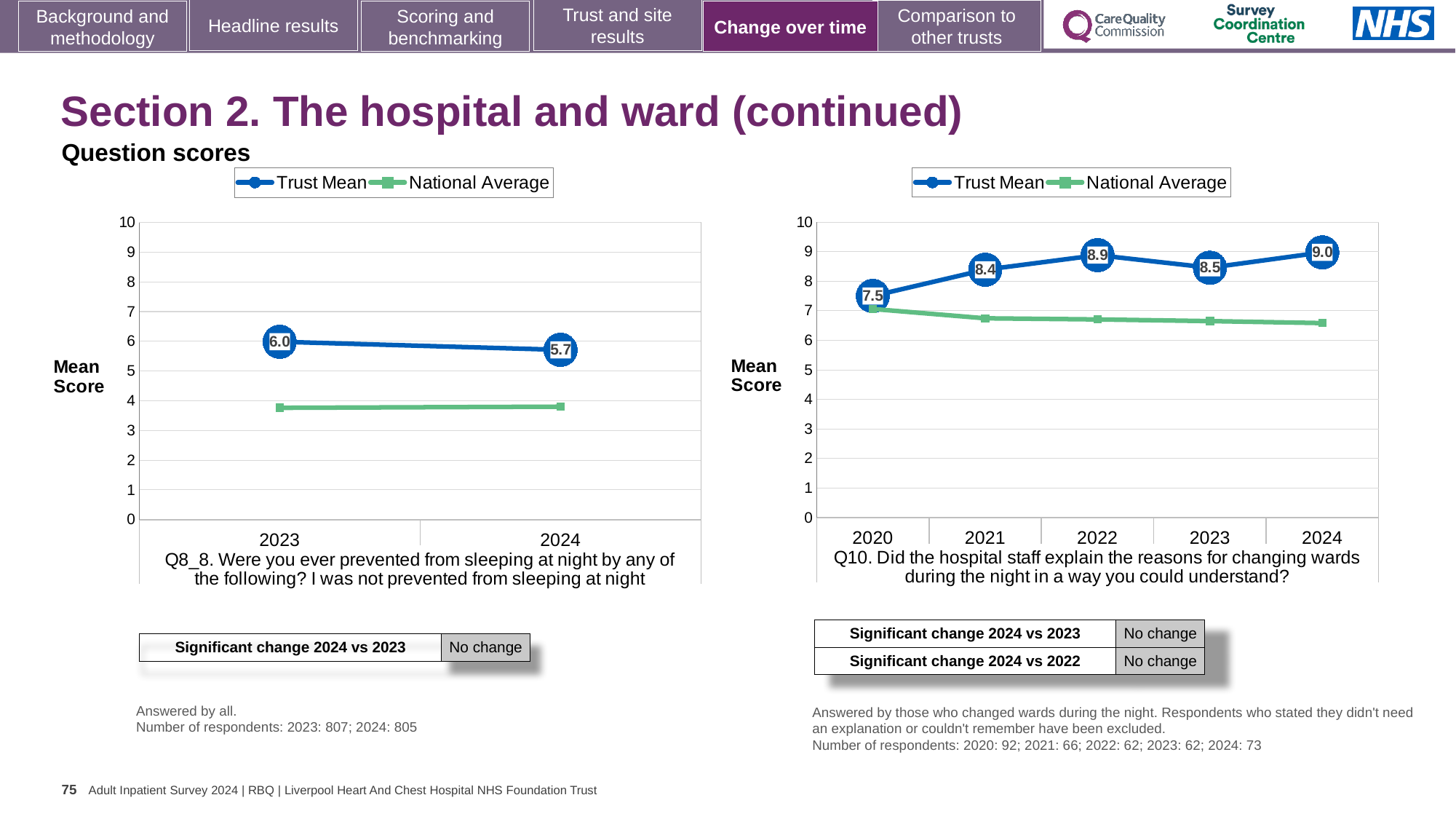
In the right chart (Q10), what is the Trust Mean value for 2022? 8.9 In the left chart (Q8_8), what is the Trust Mean value for 2024? 5.7 In the left chart (Q8_8), by how much did the Trust Mean change from 2023 to 2024? 0.3 In the right chart (Q10), which year has the highest Trust Mean? 2024 In the left chart (Q8_8), does the Trust Mean rise or fall from 2023 to 2024? fall In the left chart (Q8_8), what is the Trust Mean value for 2023? 6.0 In the right chart (Q10), which year has the lowest Trust Mean? 2020 In the right chart (Q10), what is the difference between the Trust Mean in 2024 and in 2020? 1.5 In the right chart (Q10), how many years are shown on the x axis? 5 In the left chart (Q8_8), is the National Average value for 2024 greater or less than 4? less What type of chart is used on the right (Q10)? line chart In the right chart (Q10), what is the Trust Mean value for 2020? 7.5